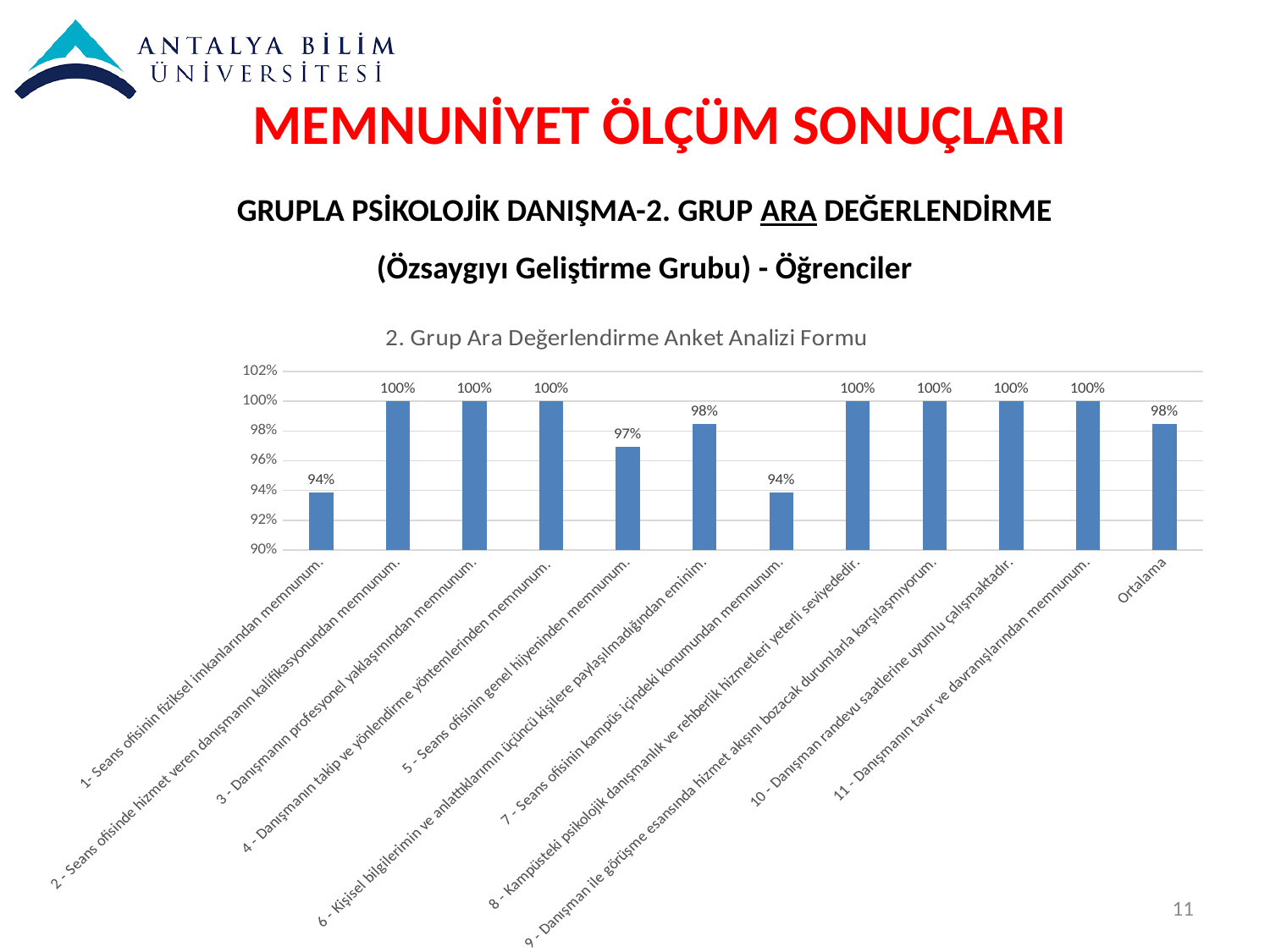
Which has a larger value: '5 - Seans ofisinin genel hijyeninden memnunum.' or '6 - Kişisel bilgilerimin ve anlattıklarımın üçüncü kişilere paylaşılmadığından eminim.'? 6 - Kişisel bilgilerimin ve anlattıklarımın üçüncü kişilere paylaşılmadığından eminim. What is the value for '5 - Seans ofisinin genel hijyeninden memnunum.'? 97% What is the value for '10 - Danışman randevu saatlerine uyumlu çalışmaktadır.'? 100% How many bars in the chart have a value of 100%? 8 What is the difference between the value for '3 - Danışmanın profesyonel yaklaşımından memnunum.' and the value for '7 - Seans ofisinin kampüs içindeki konumundan memnunum.'? 6% What is the value for '6 - Kişisel bilgilerimin ve anlattıklarımın üçüncü kişilere paylaşılmadığından eminim.'? 98% What is the lowest value shown in the chart? 94% What type of chart is shown on the slide? bar chart What is the value for '1- Seans ofisinin fiziksel imkanlarından memnunum.'? 94% What is the title of the chart? 2. Grup Ara Değerlendirme Anket Analizi Formu What is the value for 'Ortalama'? 98% How many bars are plotted in the chart? 12